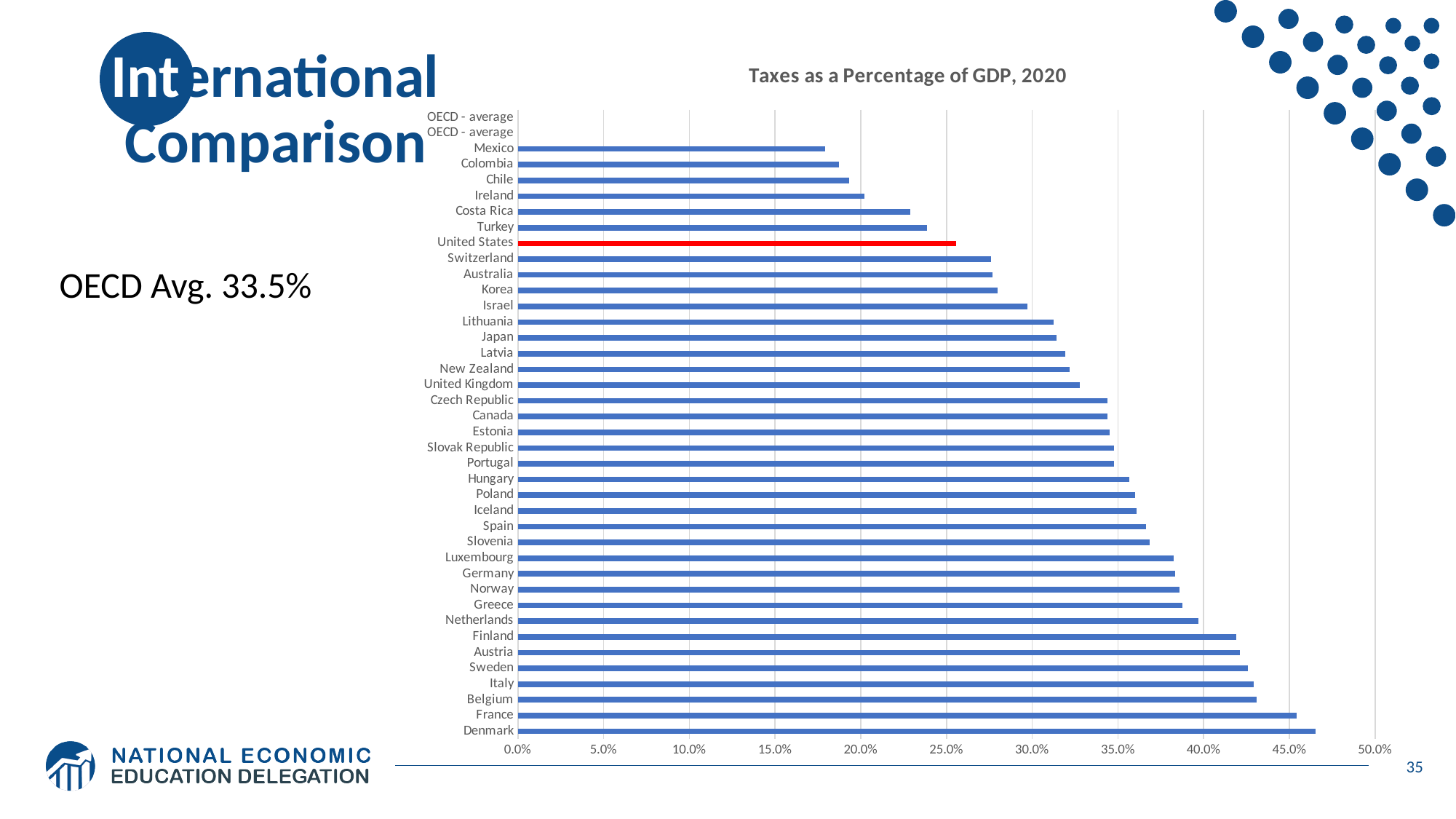
What kind of chart is shown on the slide? bar chart Is the value for the United States greater or less than 30.0%? less Which country's bar is coloured red in the chart? United States Which country has the lowest taxes as a percentage of GDP in the chart? Mexico What is the title of the chart? Taxes as a Percentage of GDP, 2020 Is the value for Finland greater or less than 40.0%? greater Which country has the highest taxes as a percentage of GDP in the chart? Denmark Which has a higher value, Germany or Japan? Germany Is the value for Mexico greater or less than 20.0%? less Which has a lower value, Sweden or Chile? Chile